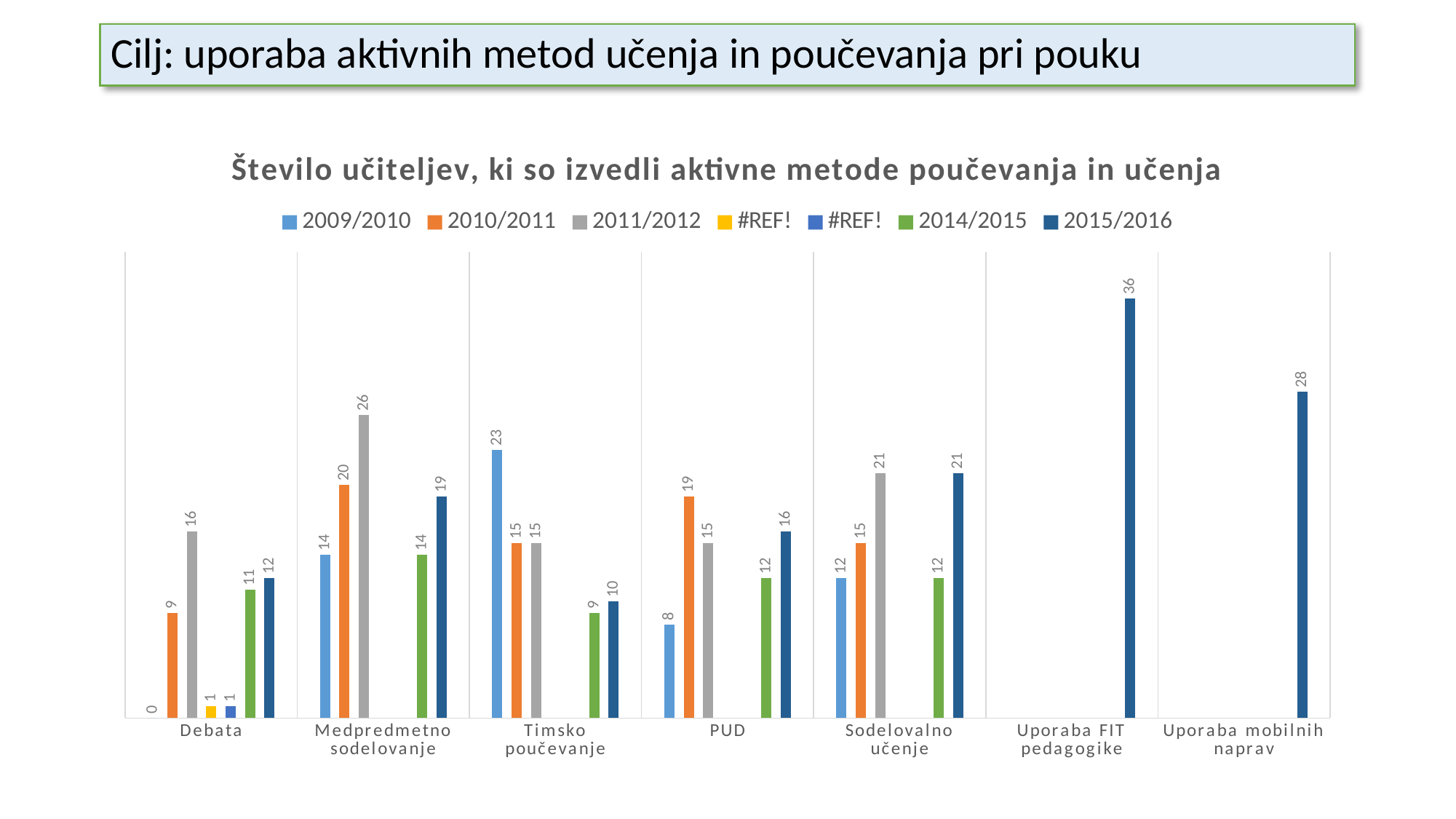
How many series does the legend list? 7 What is the difference between the 2011/2012 and 2010/2011 values in the Debata category? 7 What is the value for 2015/2016 in the Uporaba FIT pedagogike category? 36 What is the value for 2011/2012 in the Medpredmetno sodelovanje category? 26 Which category has the lowest value for the 2009/2010 series? Debata What is the difference between the 2015/2016 values for Uporaba FIT pedagogike and Uporaba mobilnih naprav? 8 What is the title of the chart? Število učiteljev, ki so izvedli aktivne metode poučevanja in učenja What is the value for 2009/2010 in the Timsko poučevanje category? 23 How many categories are shown on the x axis? 7 Which category has the highest value for the 2015/2016 series? Uporaba FIT pedagogike What type of chart is shown on the slide? bar chart Which is larger in the PUD category: the 2010/2011 value or the 2011/2012 value? 2010/2011